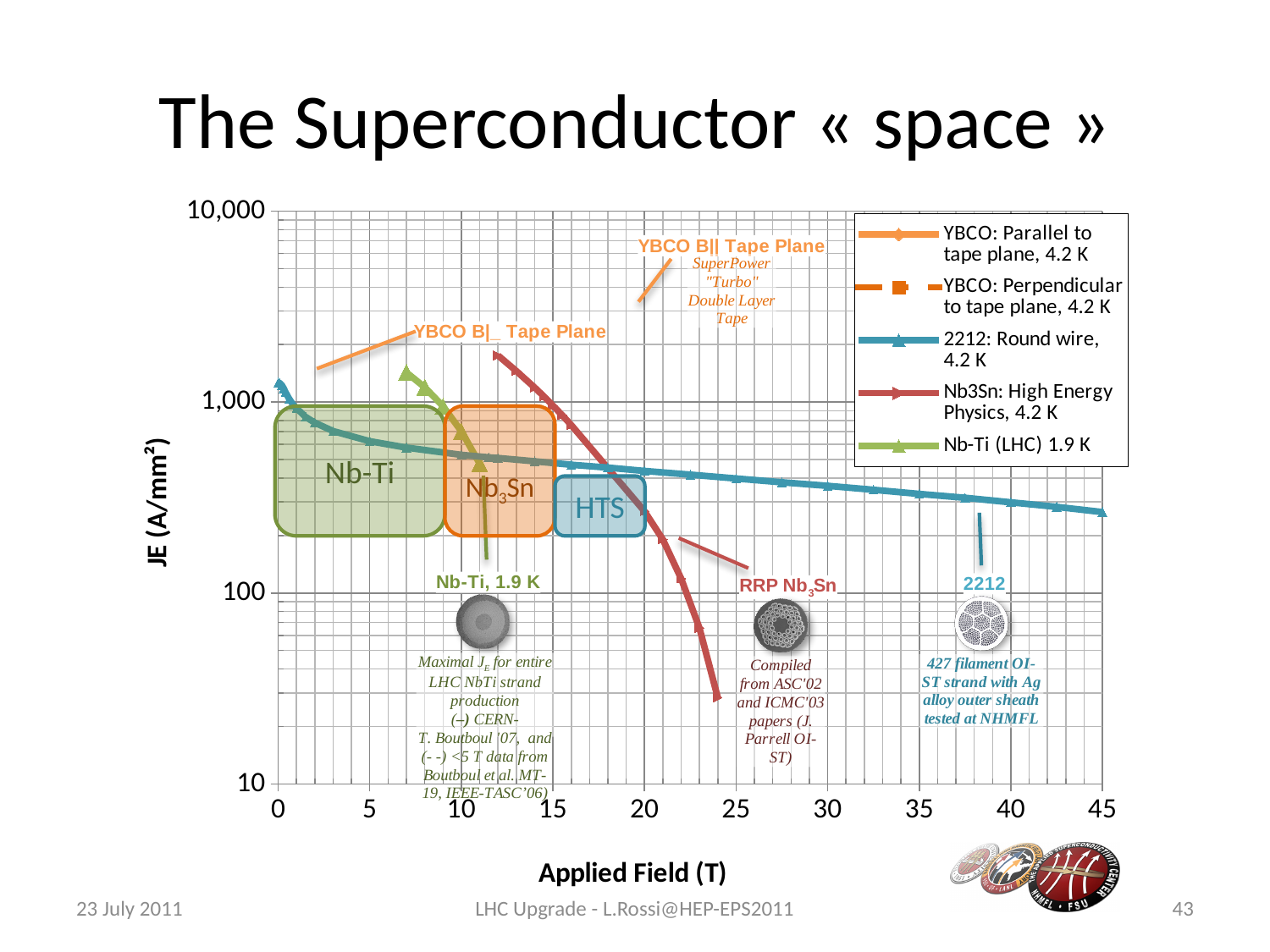
Is the value of the 'Nb3Sn: High Energy Physics, 4.2 K' series at 24 T greater or less than 100? less Does the value of the '2212: Round wire, 4.2 K' series rise or fall as the applied field increases? fall Which series extends to the highest applied field on the chart? 2212: Round wire, 4.2 K At 22 T, which series has the larger value: '2212: Round wire, 4.2 K' or 'Nb3Sn: High Energy Physics, 4.2 K'? 2212: Round wire, 4.2 K What is the highest value shown on the x axis? 45 Is the value of the 'Nb-Ti (LHC) 1.9 K' series at 7 T greater or less than 1,000? greater What is the label of the y axis? JE (A/mm²) What is the label of the x axis? Applied Field (T) Is the value of the '2212: Round wire, 4.2 K' series at 45 T greater or less than 1,000? less How many series does the legend list? 5 What kind of chart is shown on the slide? line chart